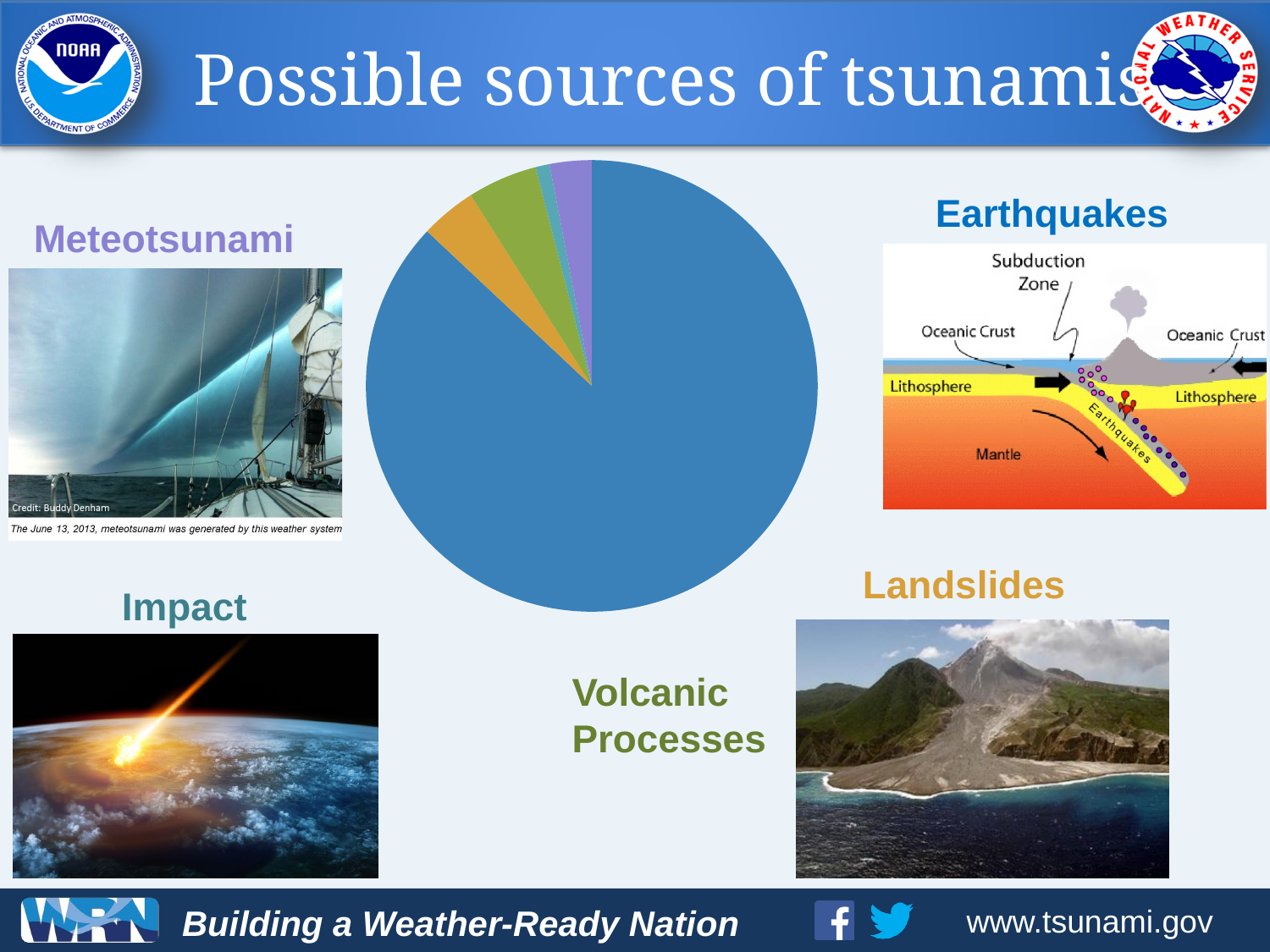
Does the pie chart display numeric data labels on its slices? No How many slices does the pie chart have? 5 Which slice is larger in the pie chart, the green (Volcanic Processes) slice or the teal (Impact) slice? Volcanic Processes Which tsunami source has the smallest slice of the pie chart? Impact What kind of chart is shown in the centre of the slide? pie chart What is the title of the slide containing the pie chart? Possible sources of tsunamis Is the share of the pie chart taken by the Earthquakes slice greater or less than 50%? greater Which tsunami source has the largest slice of the pie chart? Earthquakes Which slice is larger in the pie chart, the blue (Earthquakes) slice or the orange (Landslides) slice? Earthquakes